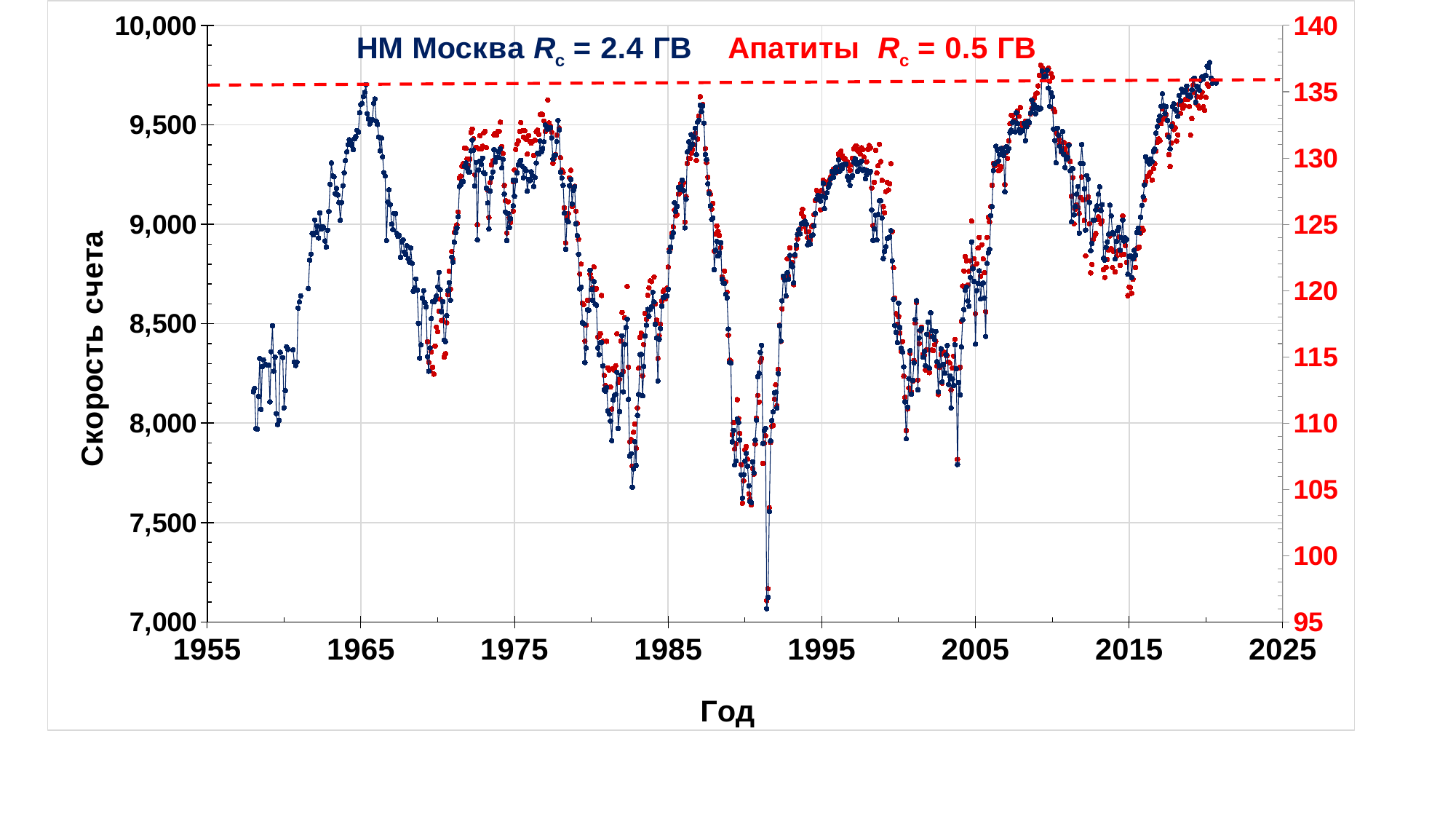
How many data series are plotted on the chart? 2 Is the lowest НМ Москва value, reached around 1991, greater or less than 7,500? less What kind of chart is shown on the slide? line chart What is the label of the x axis? Год What value of Rc is given for НМ Москва in the chart annotation? 2.4 ГВ Is the lowest Апатиты value around 1991 greater or less than 100 on the right axis? less Does the НМ Москва count rate rise or fall between 1965 and 1969? fall Is the peak НМ Москва value around 2020 greater or less than 9,500? greater Does the НМ Москва count rate rise or fall between 2015 and 2020? rise Which НМ Москва minimum is lower: the dip around 1983 or the dip around 1991? the dip around 1991